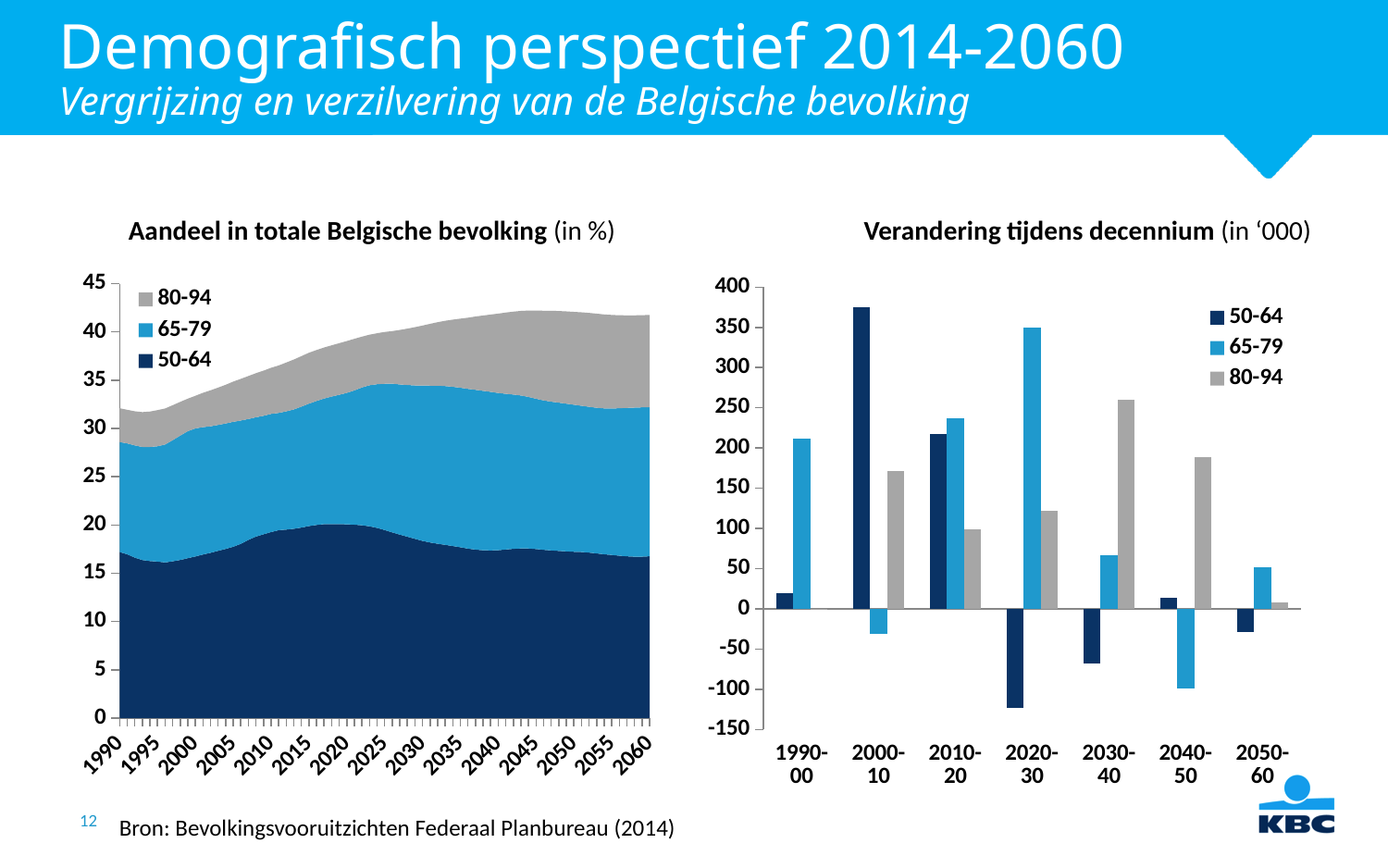
In the 'Verandering tijdens decennium' chart, is the value for 65-79 in 2040-50 greater or less than -50? less In the 'Verandering tijdens decennium' chart, in which decade is the 50-64 series lowest? 2020-30 In the 'Verandering tijdens decennium' chart, in which decade is the 80-94 series highest? 2030-40 What kind of chart is the left-hand chart, 'Aandeel in totale Belgische bevolking'? area chart In the 'Verandering tijdens decennium' chart, for 2030-40, which is larger: 80-94 or 65-79? 80-94 In the 'Verandering tijdens decennium' chart, how many decade categories are shown on the x axis? 7 In the 'Verandering tijdens decennium' chart, in which decade is the 50-64 series highest? 2000-10 What kind of chart is the right-hand chart, 'Verandering tijdens decennium'? bar chart In the 'Aandeel in totale Belgische bevolking' chart, does the share of the 80-94 group rise or fall between 1990 and 2060? rise In the 'Verandering tijdens decennium' chart, how many series does the legend list? 3 What is the title of the left-hand chart? Aandeel in totale Belgische bevolking (in %) In the 'Verandering tijdens decennium' chart, is the value for 50-64 in 2000-10 greater or less than 350? greater